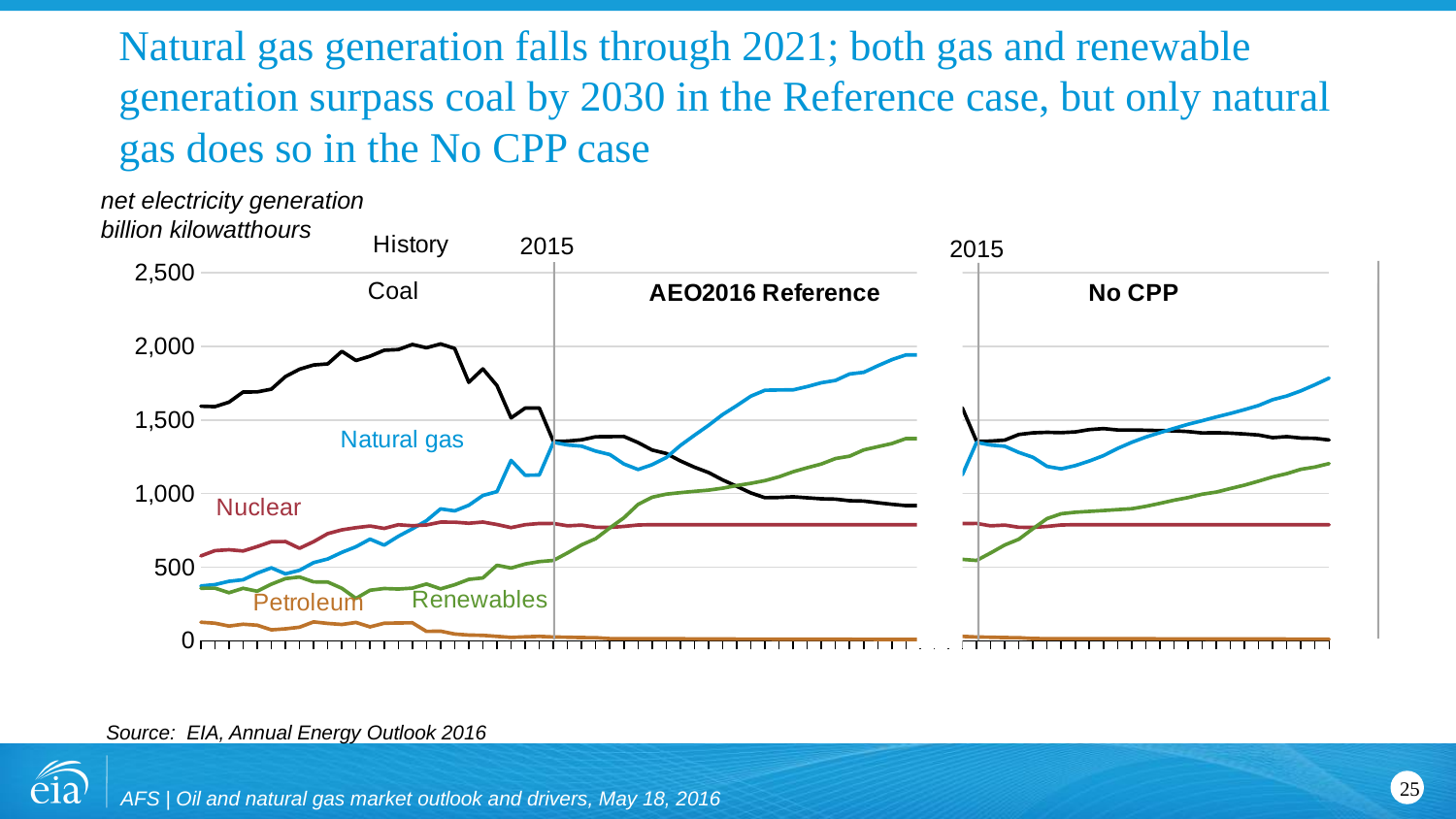
In the AEO2016 Reference panel, which is higher at the end of the projection, coal or renewables? renewables What are the titles of the two projection panels on the chart? AEO2016 Reference and No CPP Which series has the lowest values throughout the chart? Petroleum In the No CPP panel, which is higher at the end of the projection, coal or renewables? coal What kind of chart is shown on the slide? line chart In the No CPP panel, is the value for coal at the end of the projection greater or less than 1,000? greater In the No CPP panel, is the value for renewables at the end of the projection greater or less than 1,500? less In the AEO2016 Reference panel, is the value for natural gas at the end of the projection greater or less than 1,500? greater What are the units of the y axis on the chart? billion kilowatthours How many fuel series are labeled on the chart? 5 In the AEO2016 Reference panel, does coal generation rise or fall over the projection period? fall